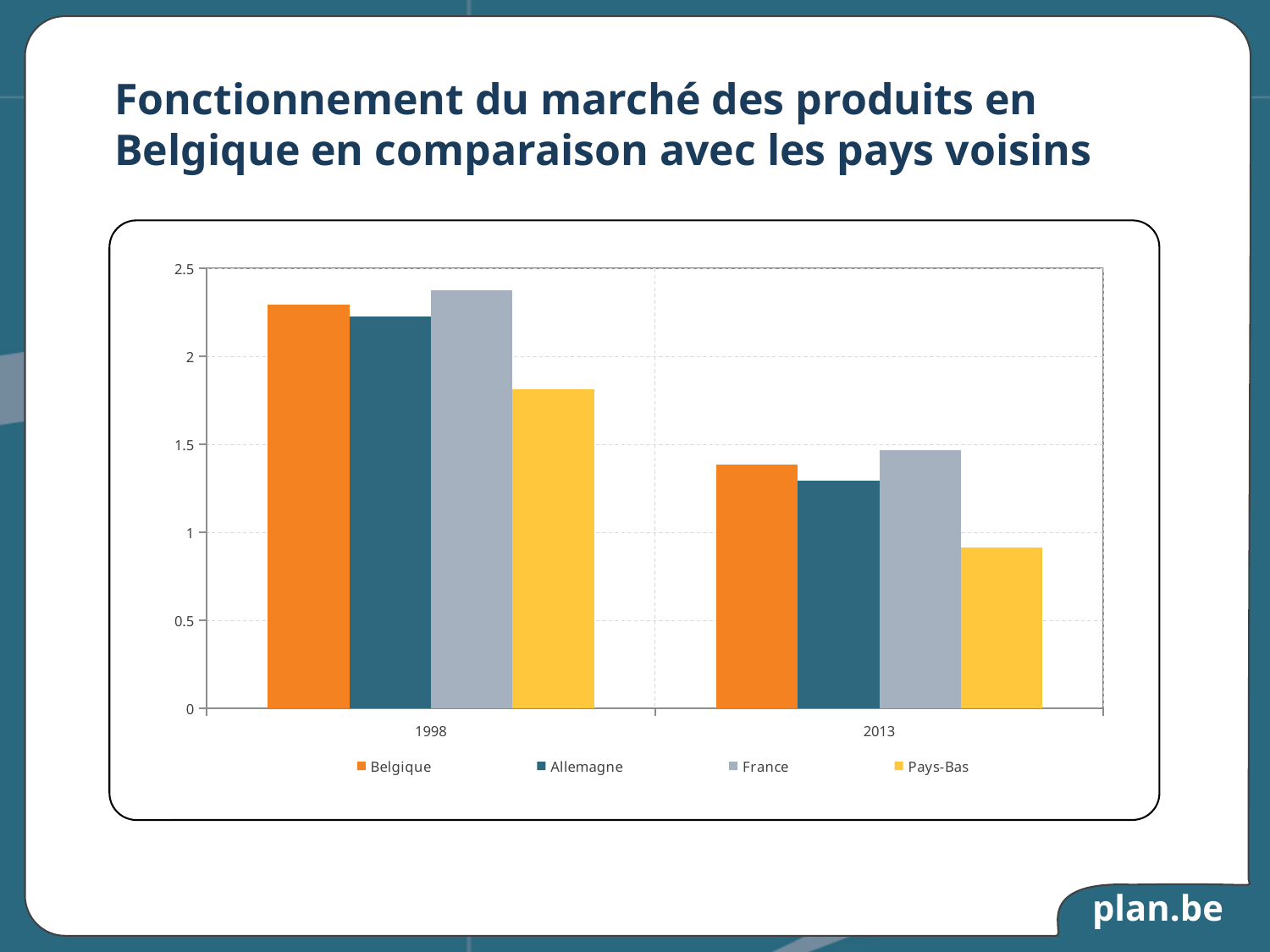
Do the values for each country rise or fall from 1998 to 2013? fall What kind of chart is shown on the slide? bar chart Is the value for Pays-Bas in 2013 greater or less than 1? less Which country has the highest value in 2013? France How many years (categories) are shown on the x axis? 2 Is the value for Belgique larger in 1998 or in 2013? 1998 Which country has the lowest value in 1998? Pays-Bas How many series does the legend list? 4 Which country has the lowest value in 2013? Pays-Bas Is the value for Belgique in 1998 greater or less than 2? greater Which country has the highest value in 1998? France